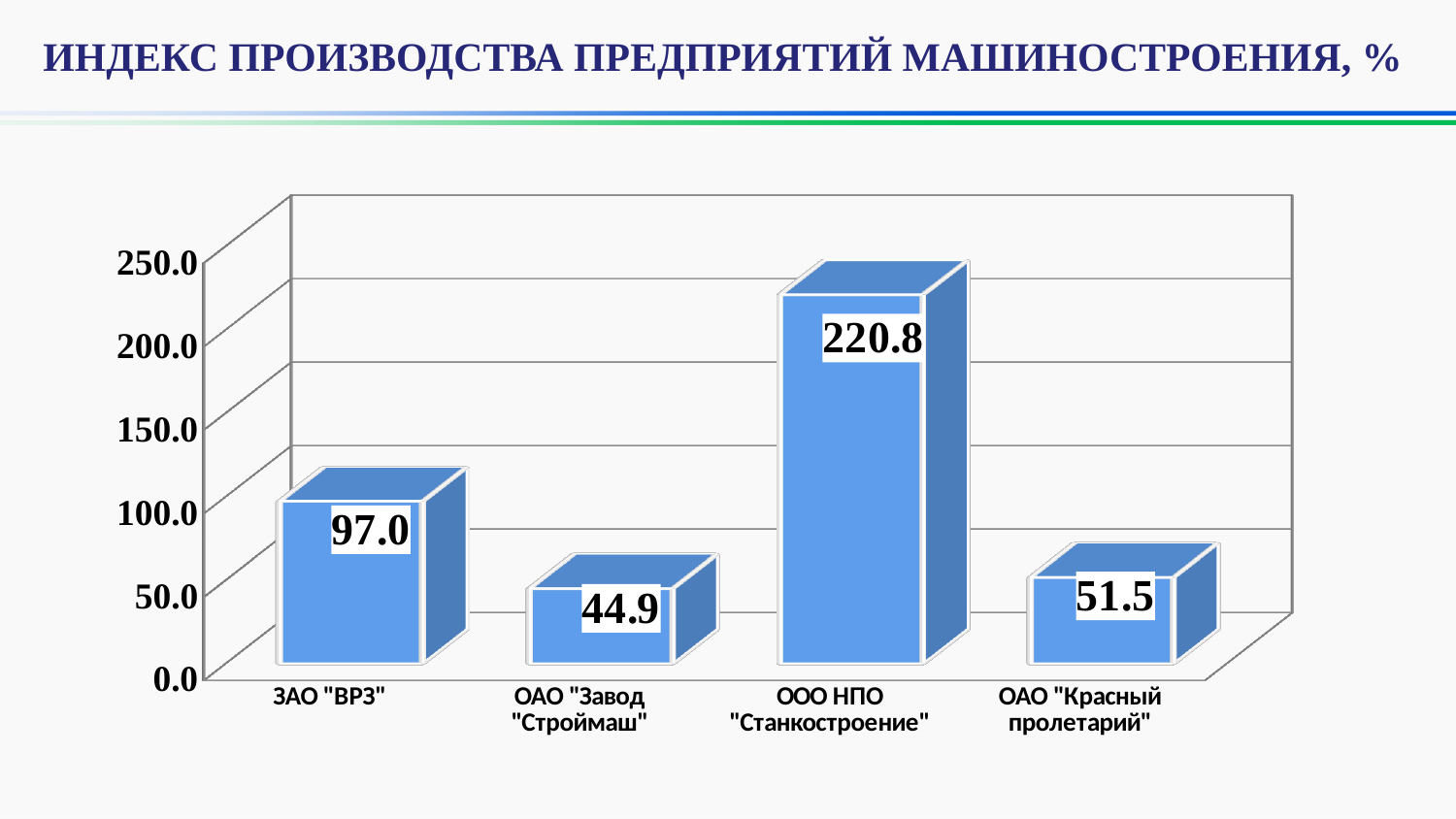
What is the value for ОАО "Красный пролетарий"? 51.5 What is the title of the chart? ИНДЕКС ПРОИЗВОДСТВА ПРЕДПРИЯТИЙ МАШИНОСТРОЕНИЯ, % Which category has the lowest value? ОАО "Завод "Строймаш" What is the difference between the values for ООО НПО "Станкостроение" and ЗАО "ВРЗ"? 123.8 Which category has the highest value? ООО НПО "Станкостроение" How many categories are shown in the chart? 4 What is the value for ООО НПО "Станкостроение"? 220.8 Is the value for ЗАО "ВРЗ" greater or less than 100.0? less What kind of chart is shown on the slide? bar chart What is the value for ОАО "Завод "Строймаш"? 44.9 What is the value for ЗАО "ВРЗ"? 97.0 Which is larger, the value for ОАО "Красный пролетарий" or the value for ОАО "Завод "Строймаш"? ОАО "Красный пролетарий"